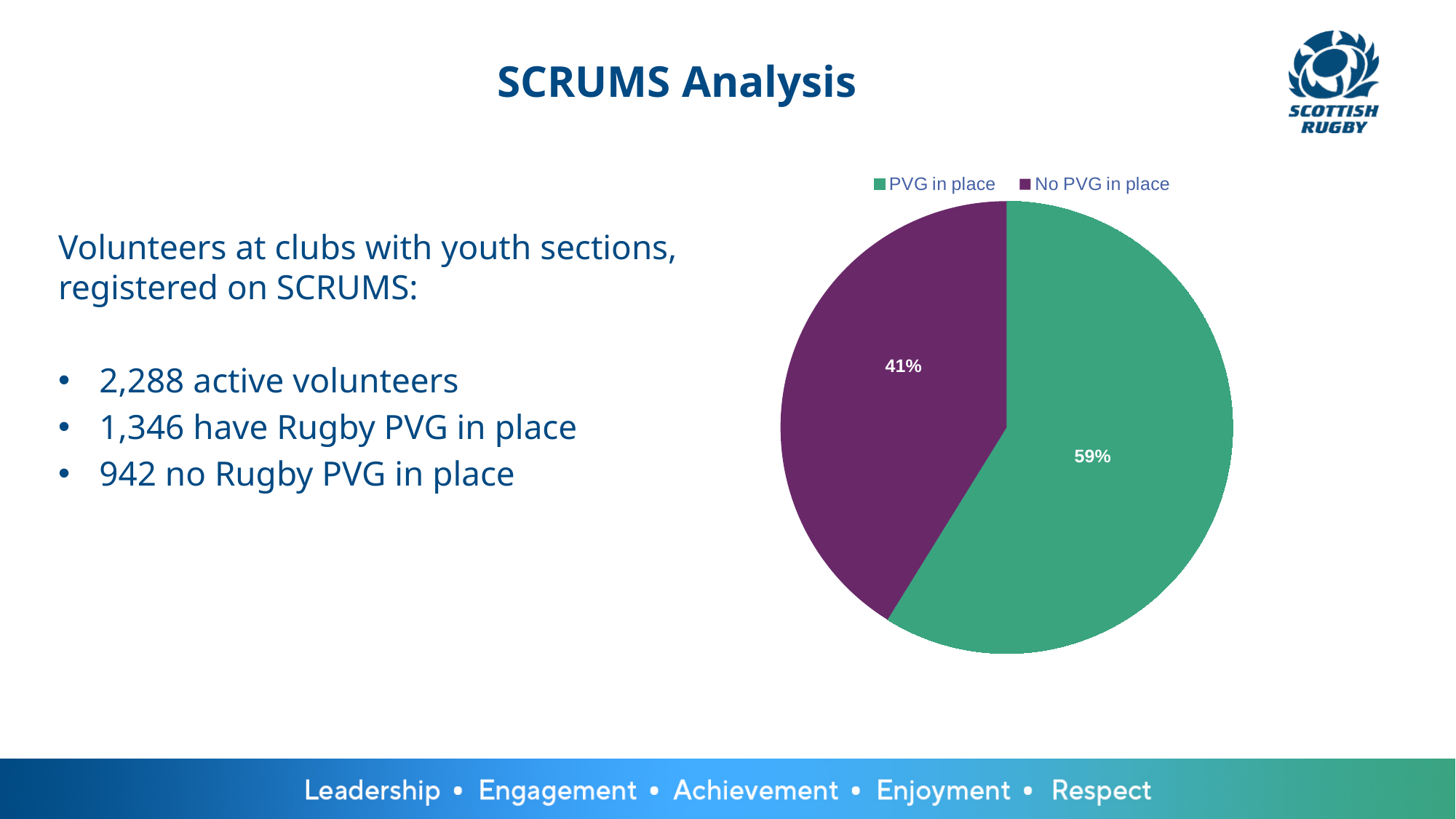
What share of the pie does the 'No PVG in place' slice represent? 41% What is the difference in percentage points between the 'PVG in place' and 'No PVG in place' slices? 18 What percentage of the pie chart is labelled 'No PVG in place'? 41% How many entries does the pie chart's legend list? 2 What percentage of the pie chart is labelled 'PVG in place'? 59% How many slices does the pie chart have? 2 Which is larger in the pie chart: 'PVG in place' or 'No PVG in place'? PVG in place Which slice of the pie chart is the largest? PVG in place What colour is the 'PVG in place' slice in the pie chart? green What type of chart is shown on the slide? pie chart Which slice of the pie chart is the smallest? No PVG in place What colour is the 'No PVG in place' slice in the pie chart? purple